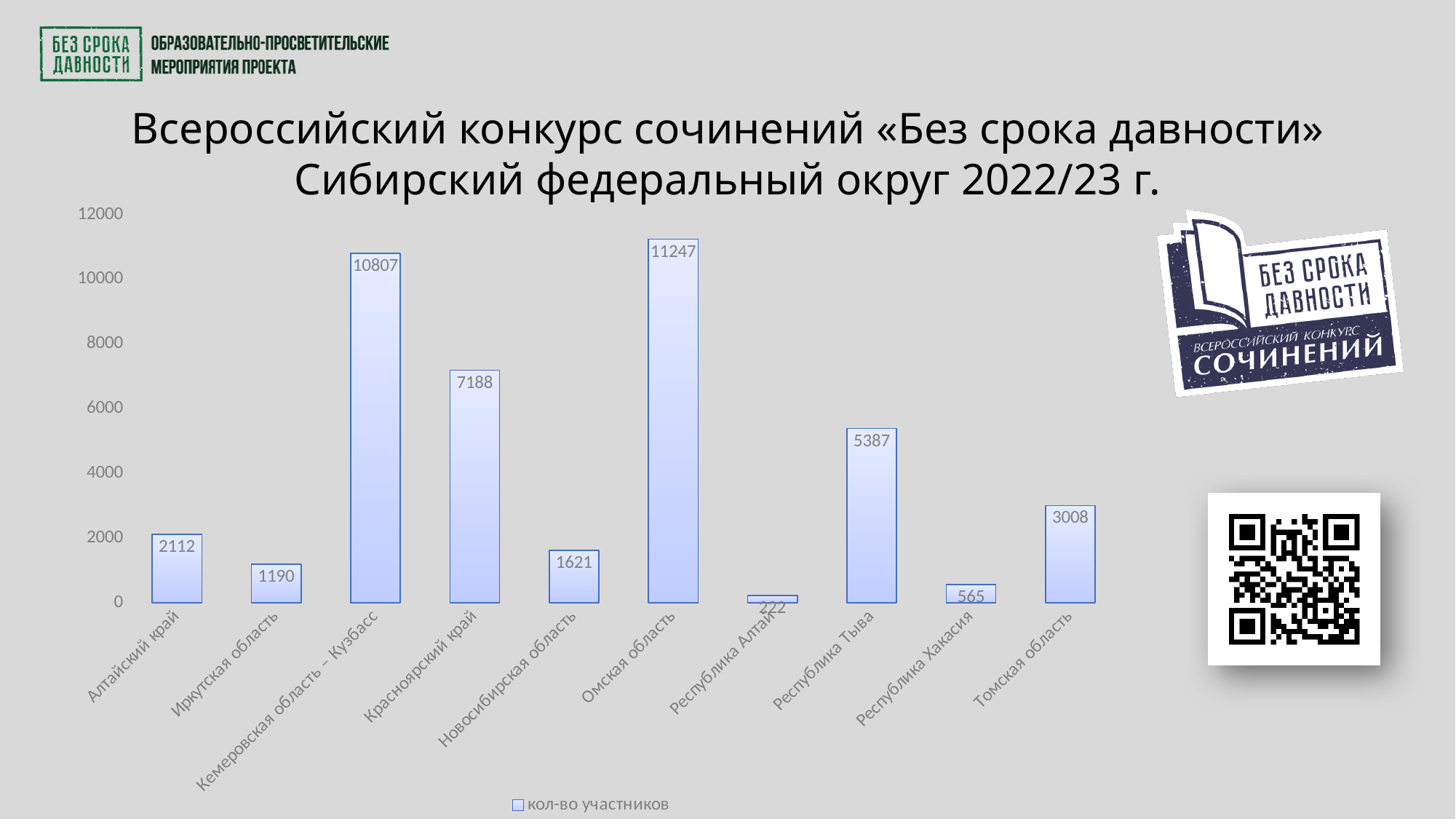
Which is larger, the value for Алтайский край or the value for Томская область? Томская область What kind of chart is shown on the slide? bar chart What is the legend entry for the series? кол-во участников How many categories are shown on the x axis? 10 Is the value for Красноярский край greater or less than 6000? greater What is the value for Республика Хакасия? 565 What is the value for Кемеровская область – Кузбасс? 10807 How many series does the legend list? 1 What is the value for Омская область? 11247 What is the difference between the values for Красноярский край and Республика Тыва? 1801 Which category has the highest value? Омская область Which category has the lowest value? Республика Алтай